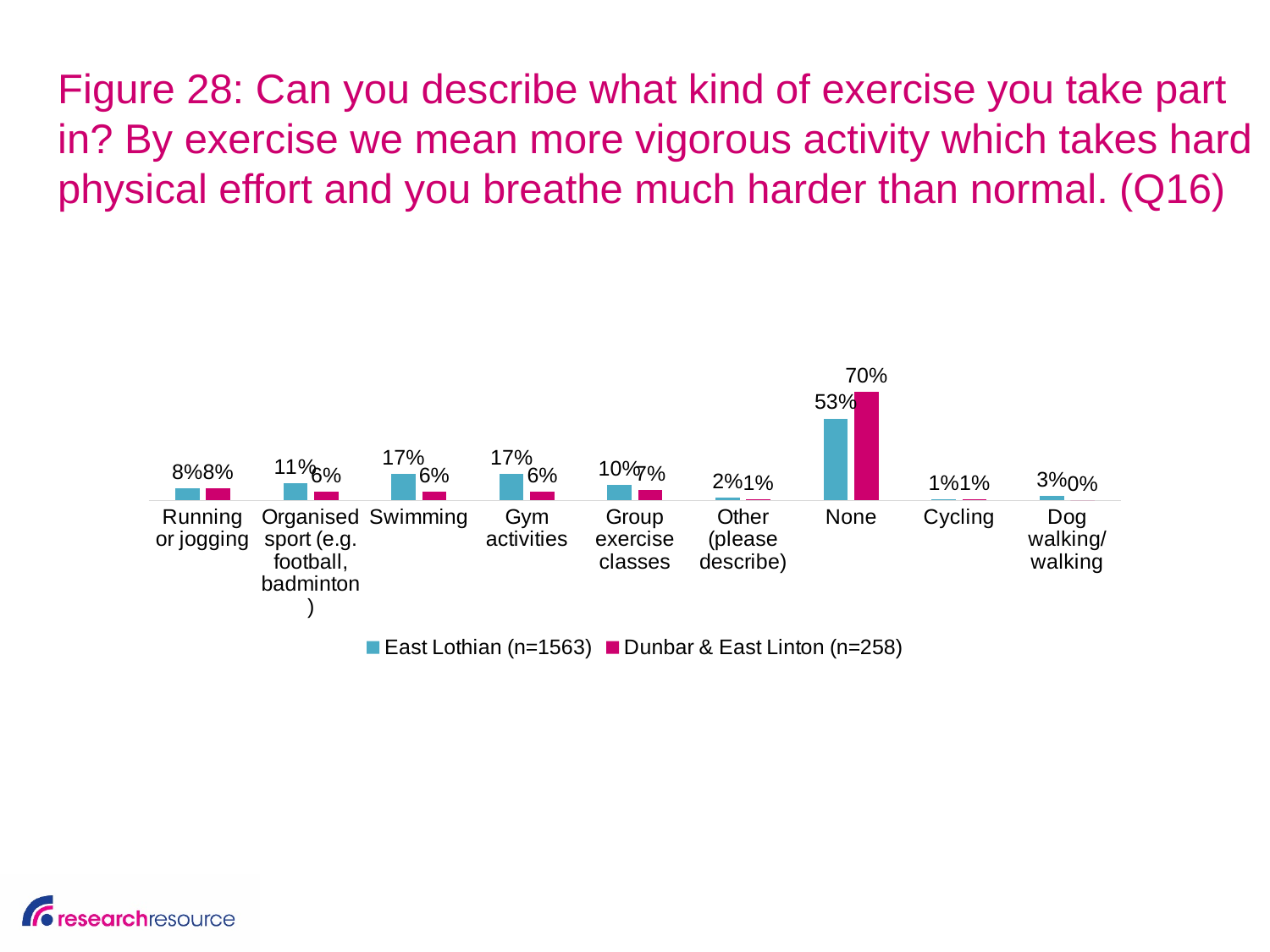
What is the value for None in the Dunbar & East Linton (n=258) series? 70% What kind of chart is shown on the slide? Bar chart Which category has the lowest value in the Dunbar & East Linton (n=258) series? Dog walking/ walking Which series has the larger value for Organised sport (e.g. football, badminton)? East Lothian (n=1563) What is the difference between the Dunbar & East Linton (n=258) and East Lothian (n=1563) values for None? 17% What is the value for None in the East Lothian (n=1563) series? 53% How many series does the legend list? 2 What is the value for Gym activities in the Dunbar & East Linton (n=258) series? 6% How many categories are shown on the x axis? 9 Which category has the highest value in the Dunbar & East Linton (n=258) series? None What is the value for Swimming in the East Lothian (n=1563) series? 17% What is the difference between the East Lothian (n=1563) and Dunbar & East Linton (n=258) values for Swimming? 11%